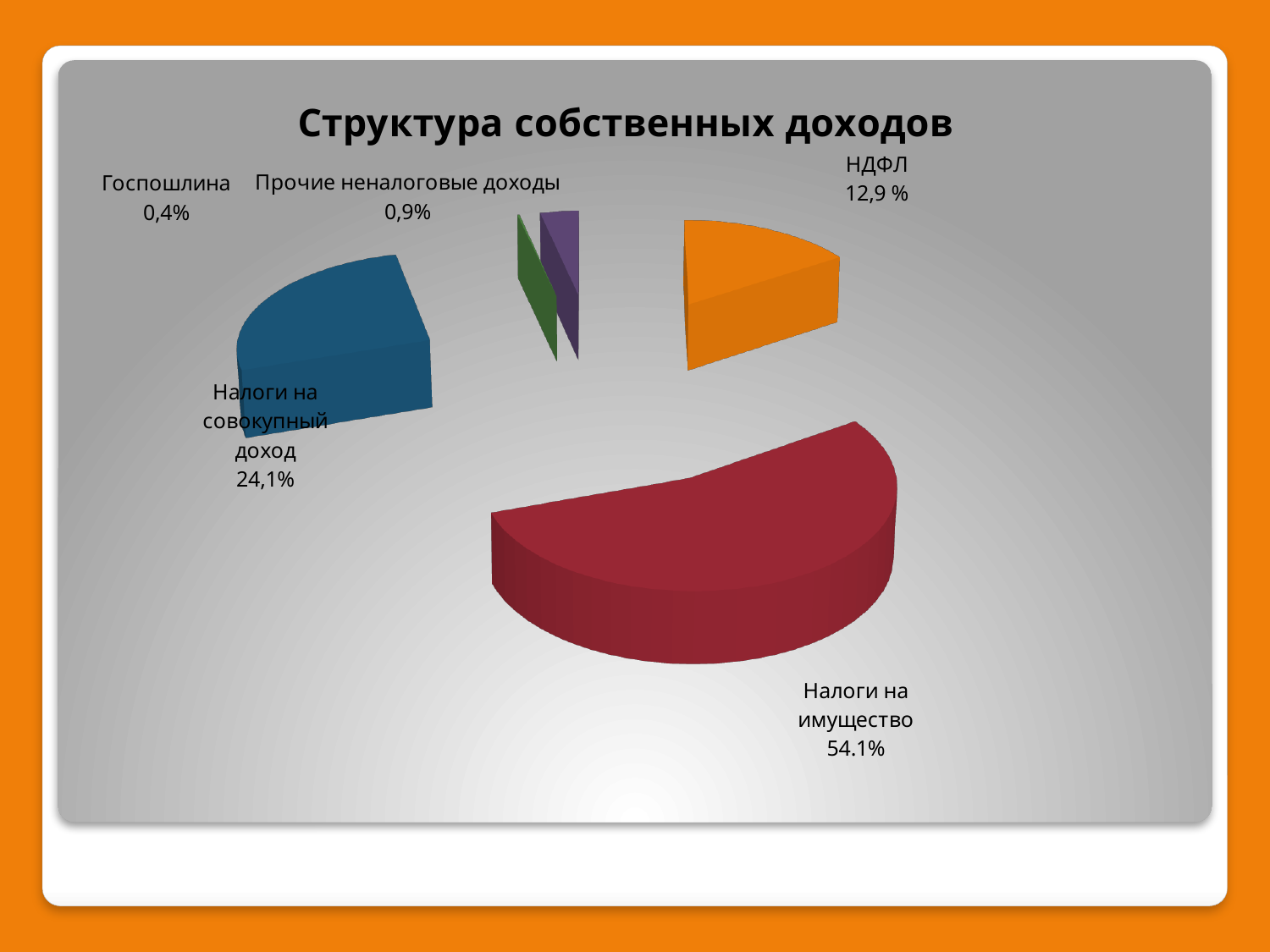
What share of the pie does Налоги на имущество account for? 54.1% Which category has the smallest share of the pie? Госпошлина What is the value shown for Прочие неналоговые доходы? 0,9% Which category has the largest share of the pie? Налоги на имущество What is the difference in percentage points between Налоги на совокупный доход and НДФЛ? 11,2 What is the value shown for НДФЛ? 12,9 % How many slices does the pie chart have? 5 What type of chart is shown on the slide? pie chart Which is larger, the share for НДФЛ or the share for Налоги на совокупный доход? Налоги на совокупный доход What is the value shown for Налоги на совокупный доход? 24,1% What is the value shown for Госпошлина? 0,4% What is the title of the chart? Структура собственных доходов